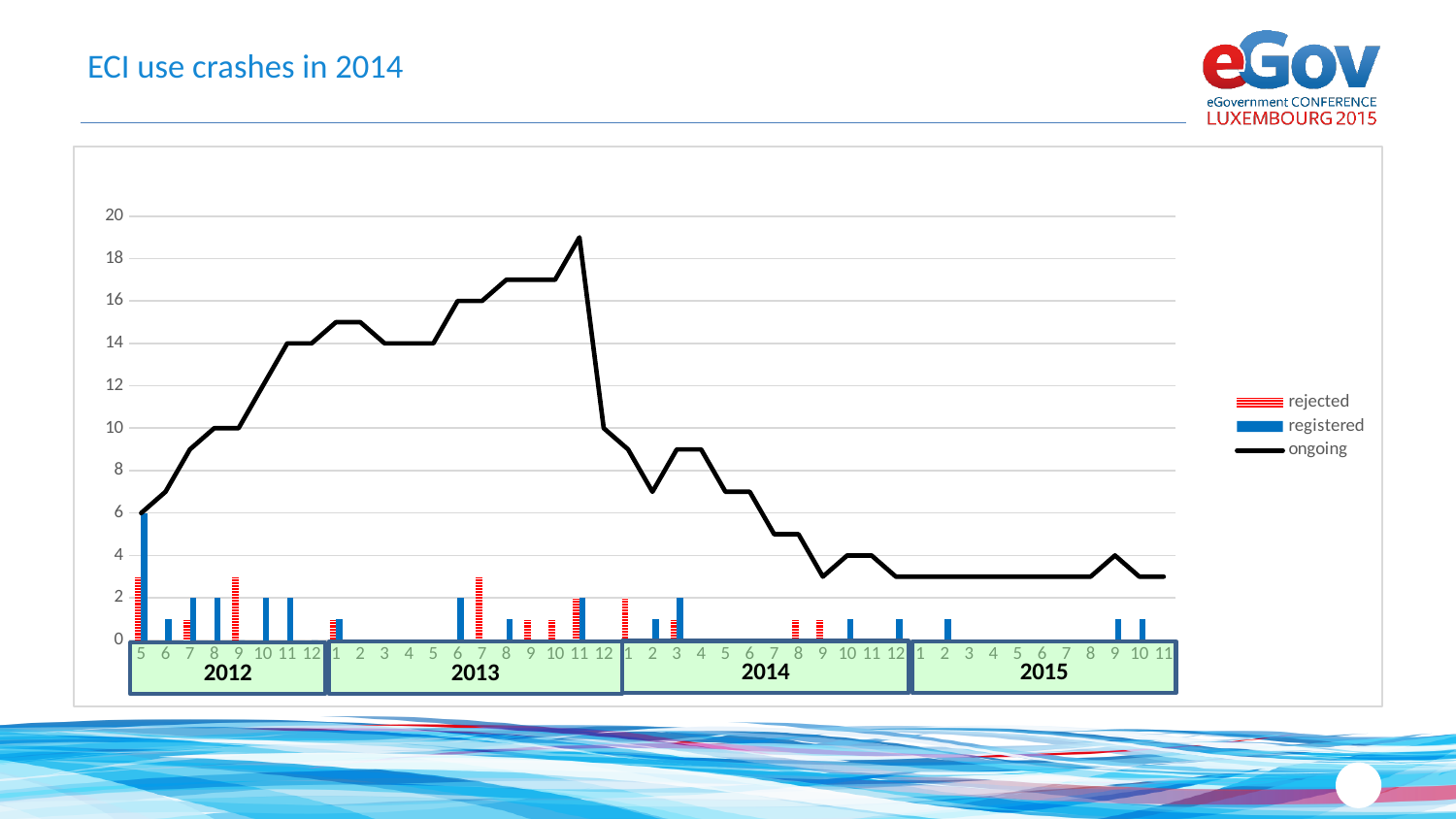
Is the ongoing value in month 11 of 2013 greater or less than 18? greater Which series is drawn as a line rather than bars? ongoing How many years are labelled along the x axis? 4 Is the ongoing value in month 1 of 2014 greater or less than 12? less What kind of chart is this? Combined bar and line chart What is the title of the chart on this slide? ECI use crashes in 2014 Is the ongoing value in month 8 of 2013 greater or less than 16? greater In which month and year does the ongoing line reach its highest value? November 2013 (month 11 of 2013) Which is larger, the ongoing value in month 11 of 2013 or in month 11 of 2014? Month 11 of 2013 How many series does the legend list? 3 Does the ongoing line generally rise or fall across 2014? fall